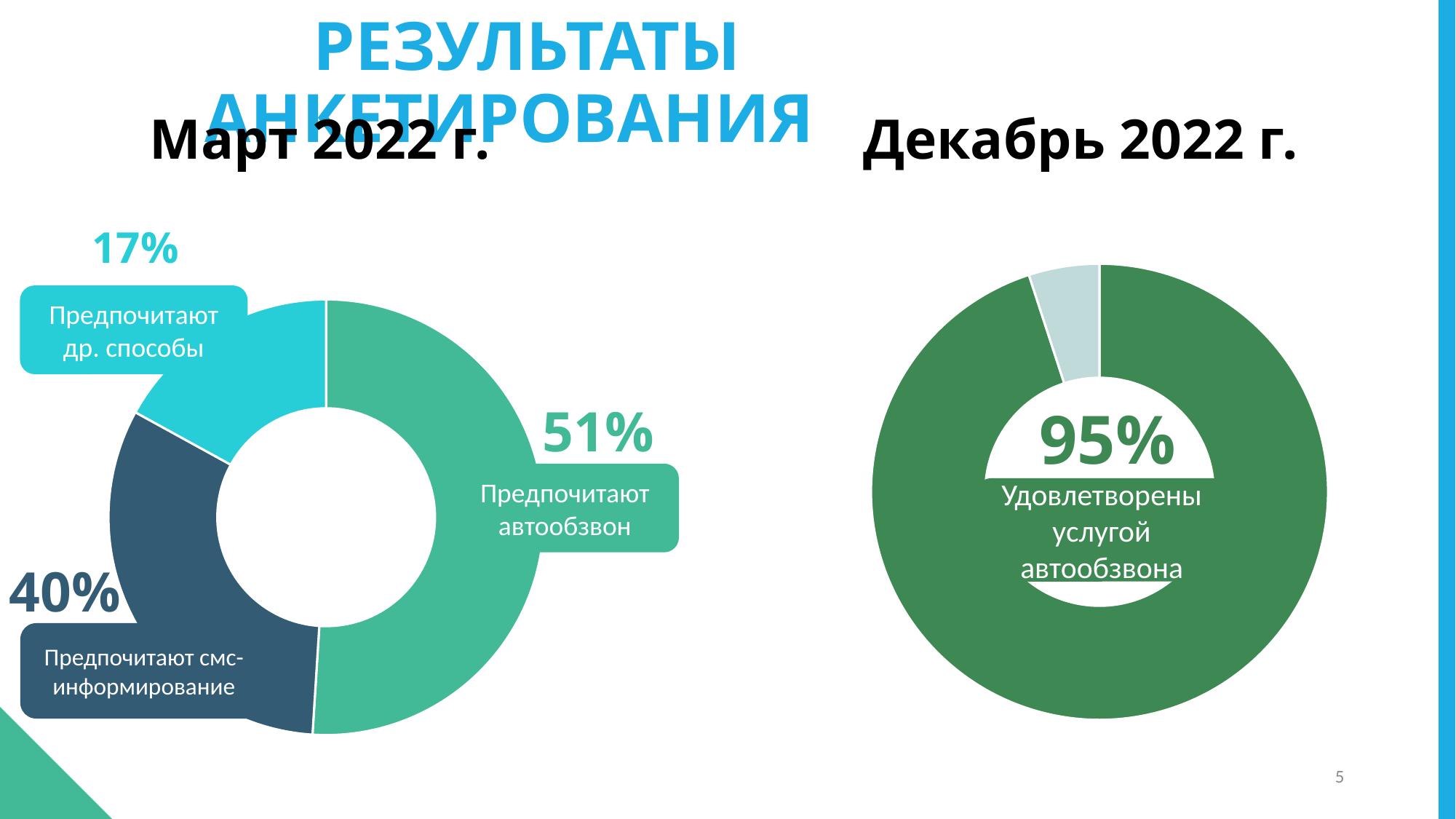
In the 'Март 2022 г.' chart, what is the difference between the shares for 'Предпочитают автообзвон' and 'Предпочитают др. способы'? 34% In the 'Март 2022 г.' chart, which category has the largest share? Предпочитают автообзвон What label is printed in the centre of the 'Декабрь 2022 г.' chart below the percentage? Удовлетворены услугой автообзвона What kind of chart is the 'Март 2022 г.' chart? doughnut chart In the 'Март 2022 г.' chart, which is larger: 'Предпочитают смс-информирование' or 'Предпочитают др. способы'? Предпочитают смс-информирование In the 'Март 2022 г.' chart, what percentage is shown for 'Предпочитают смс-информирование'? 40% In the 'Март 2022 г.' chart, what percentage is shown for 'Предпочитают др. способы'? 17% In the 'Март 2022 г.' chart, what percentage is shown for 'Предпочитают автообзвон'? 51% In the 'Декабрь 2022 г.' chart, what percentage is shown for 'Удовлетворены услугой автообзвона'? 95% In the 'Март 2022 г.' chart, what is the difference between the shares for 'Предпочитают автообзвон' and 'Предпочитают смс-информирование'? 11% How many slices does the 'Март 2022 г.' chart have? 3 In the 'Март 2022 г.' chart, which category has the smallest share? Предпочитают др. способы